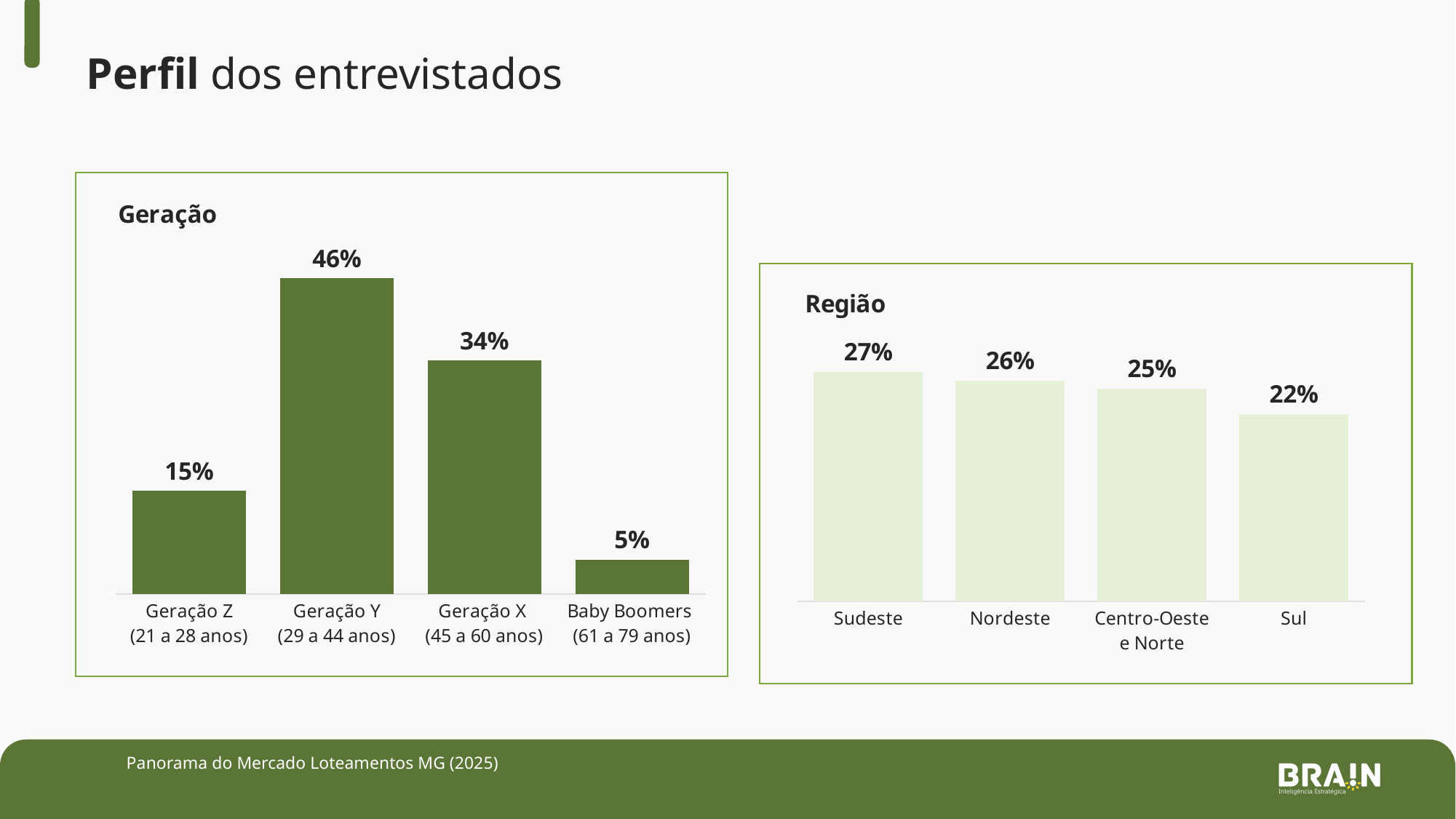
In the "Região" chart, which region has the lowest value? Sul In the "Geração" chart, what is the value for Baby Boomers (61 a 79 anos)? 5% What kind of chart is the "Região" chart? bar chart In the "Geração" chart, how many categories are shown? 4 In the "Geração" chart, which generation has the lowest value? Baby Boomers (61 a 79 anos) In the "Geração" chart, which generation has the highest value? Geração Y (29 a 44 anos) In the "Região" chart, do the values rise or fall from left to right? fall In the "Geração" chart, what is the difference between Geração Y and Geração X? 12% In the "Geração" chart, what is the value for Geração Y (29 a 44 anos)? 46% In the "Região" chart, what is the value for Centro-Oeste e Norte? 25% In the "Região" chart, what is the difference between Sudeste and Sul? 5% In the "Região" chart, what is the value for Sudeste? 27%